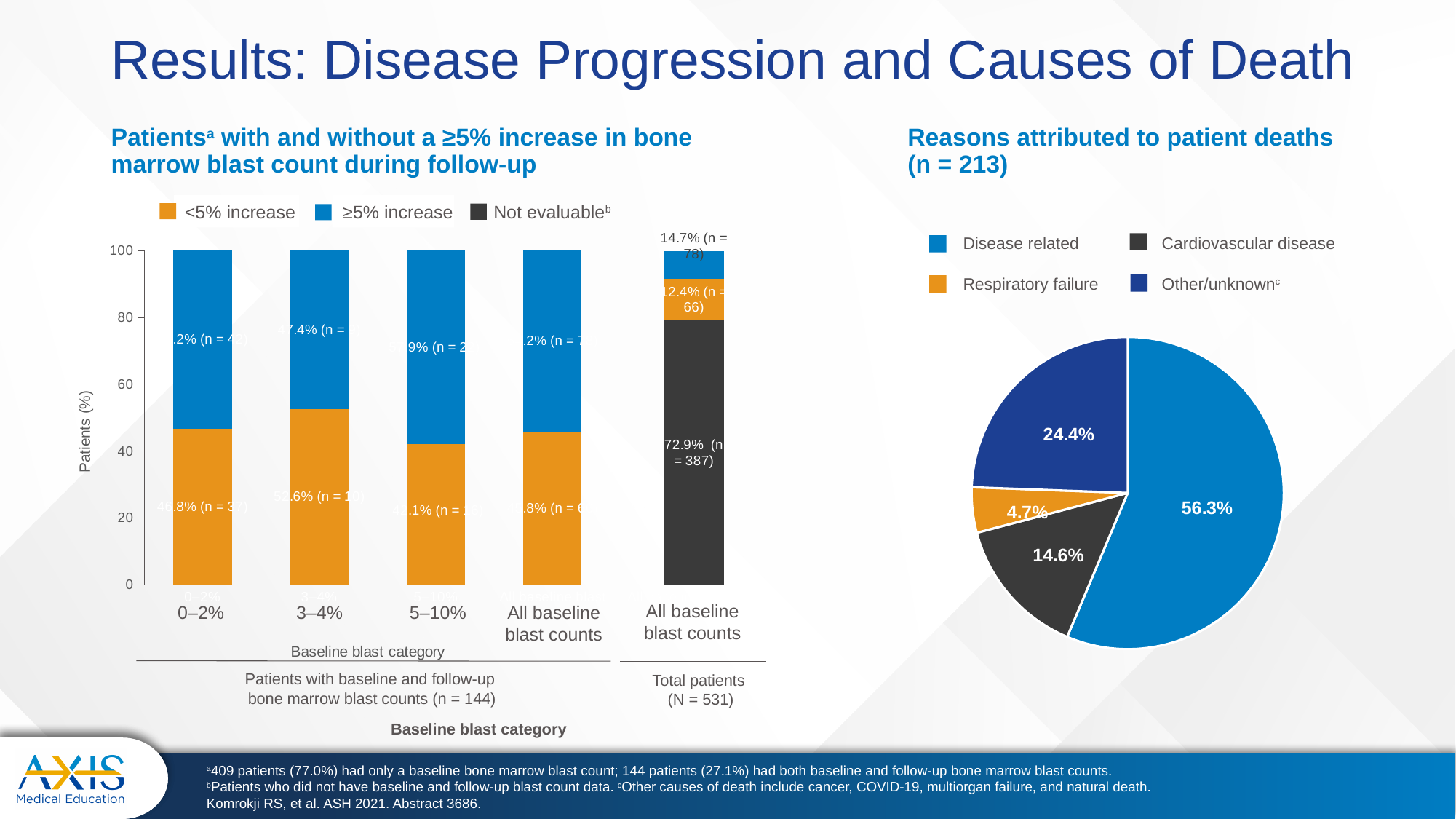
In the pie chart 'Reasons attributed to patient deaths', what percentage of deaths is attributed to disease related causes? 56.3% In the pie chart 'Reasons attributed to patient deaths', which cause accounts for the smallest share of deaths? Respiratory failure How many slices does the pie chart 'Reasons attributed to patient deaths' have? 4 How many series does the legend of the stacked bar chart on the left list? 3 In the pie chart 'Reasons attributed to patient deaths', how many percentage points larger is the disease related share than the other/unknown share? 31.9% In the pie chart 'Reasons attributed to patient deaths', what percentage is attributed to respiratory failure? 4.7% In the pie chart 'Reasons attributed to patient deaths', which cause accounts for the largest share of deaths? Disease related In the stacked bar chart on the left, what is the value labelled for 'Not evaluable' in the Total patients (N = 531) bar? 72.9% (n = 387) In the pie chart 'Reasons attributed to patient deaths', what percentage is attributed to cardiovascular disease? 14.6% In the stacked bar chart on the left, what is the value labelled for '<5% increase' in the 0–2% baseline blast category? 46.8% (n = 37) In the stacked bar chart on the left, what is the value labelled for '≥5% increase' in the Total patients (N = 531) bar? 14.7% (n = 78) In the stacked bar chart on the left, for the 3–4% baseline blast category, which is larger: the '<5% increase' segment or the '≥5% increase' segment? <5% increase